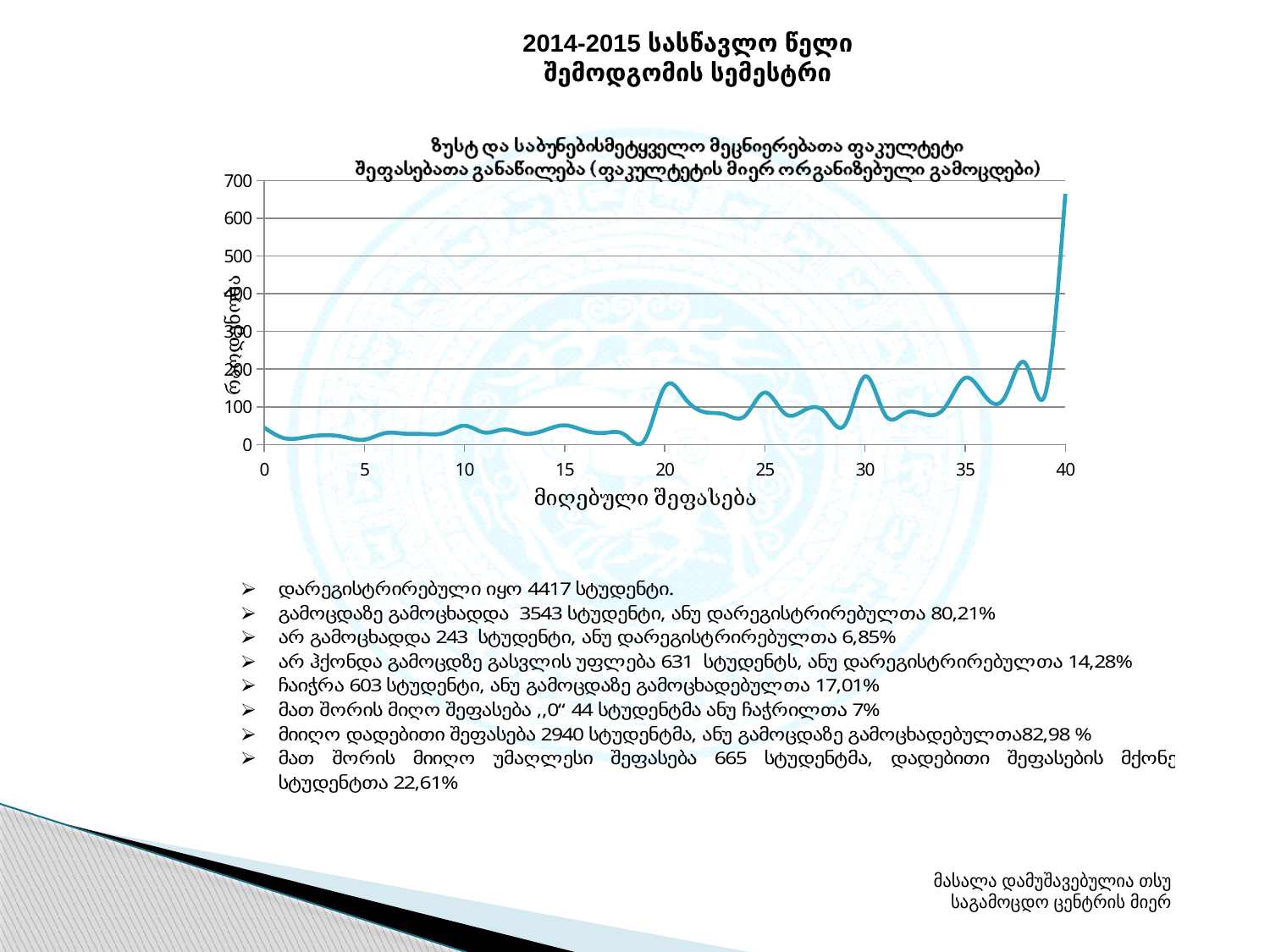
What is the highest tick value shown on the y axis of the chart? 700 Is the value of the line at x = 35 greater or less than 100? greater Is the value of the line at x = 30 greater or less than 100? greater At which x-axis value does the line reach its highest point? 40 Which is larger: the value of the line at x = 40 or at x = 20? x = 40 Is the line higher or lower at x = 40 than at x = 0? higher What kind of chart is shown on the slide? line chart Is the value of the line at x = 5 greater or less than 100? less What is the label of the x axis of the chart? მიღებული შეფასება